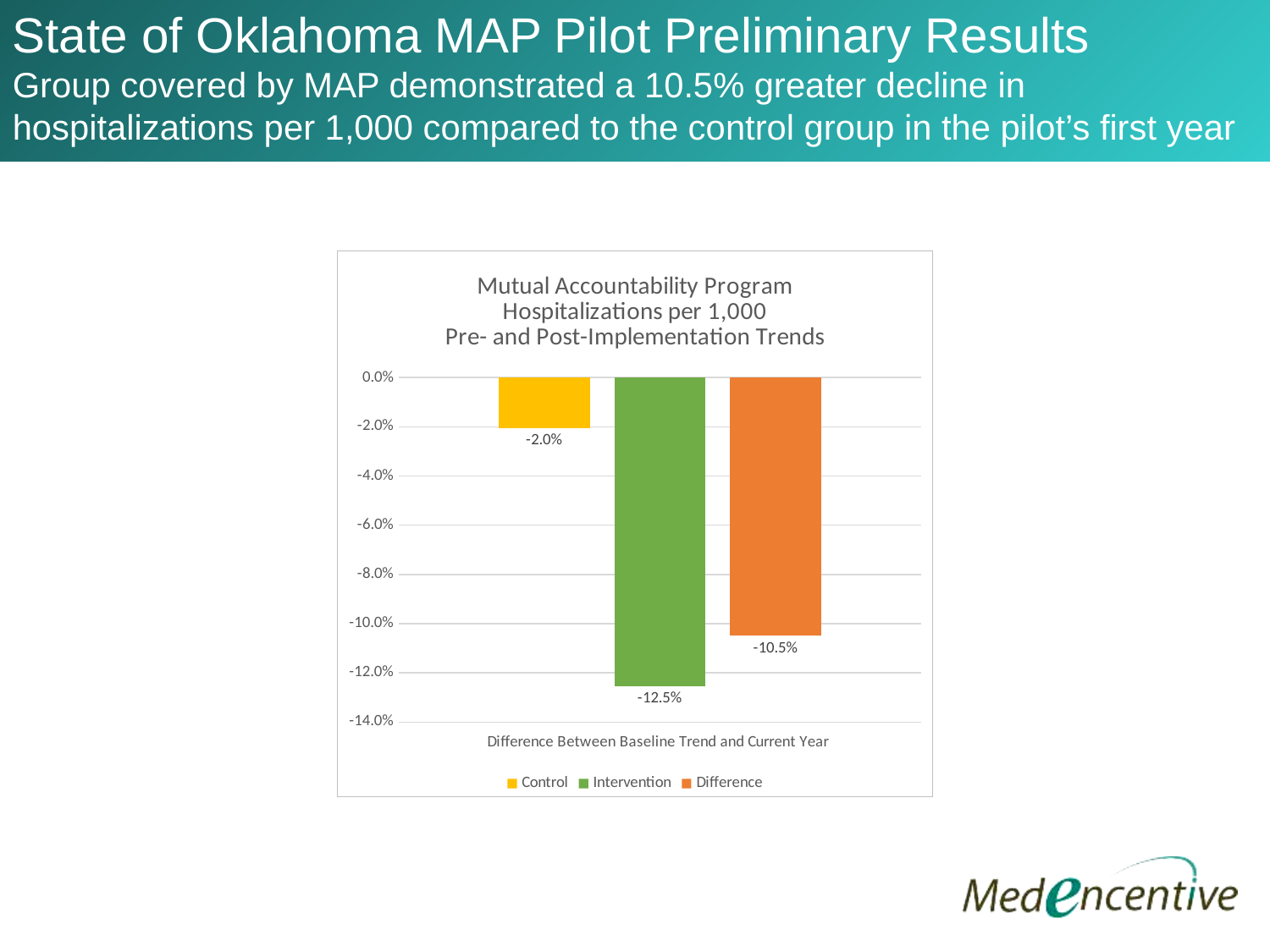
What is the value for Intervention? -12.5% Which is larger in magnitude, the Intervention value or the Difference value? Intervention How many series does the legend list? 3 What is the title of the chart? Mutual Accountability Program Hospitalizations per 1,000 Pre- and Post-Implementation Trends Which series has the highest (least negative) value? Control What is the value for Difference? -10.5% What kind of chart is shown? Bar chart Which series has the lowest (most negative) value? Intervention How many bars are plotted in the chart? 3 What is the value for Control? -2.0% What is the difference between the Control value and the Intervention value? 10.5% What is the x-axis category label? Difference Between Baseline Trend and Current Year